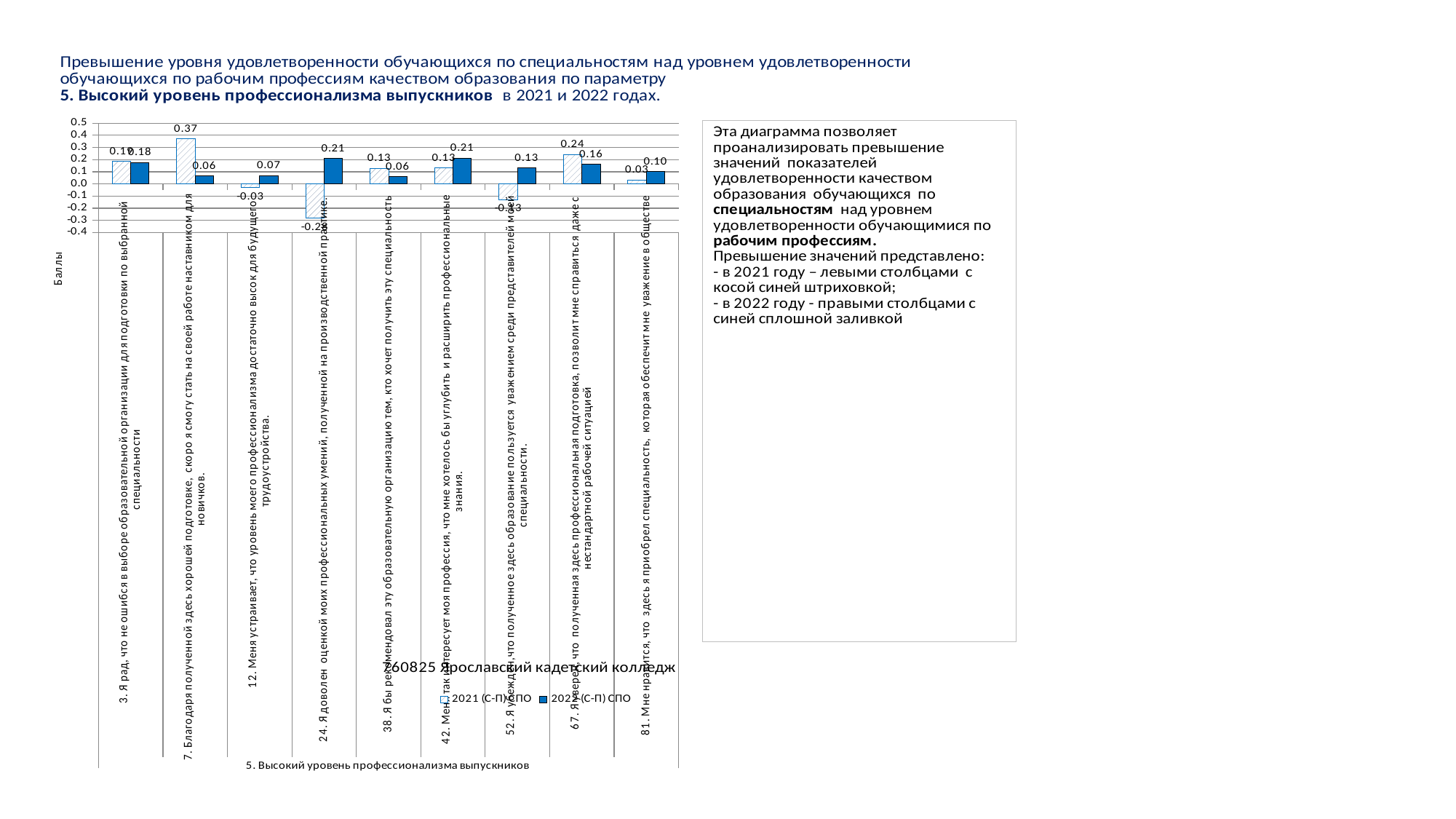
Which statement has the lowest 2021 (С-П) СПО value? 24. Я доволен оценкой моих профессиональных умений, полученной на производственной практике. What is the label of the vertical axis of the chart? Баллы How many series does the chart legend list? 2 Which statement has the lowest 2022 (С-П) СПО value? Statements 7 and 38 are tied at 0.06 (7. Благодаря полученной здесь хорошей подготовке... and 38. Я бы рекомендовал эту образовательную организацию...) How many statement categories are plotted along the x axis of the chart? 9 For statement 67 (Я уверен, что полученная здесь профессиональная подготовка...), which is larger: the 2021 or the 2022 (С-П) СПО value? 2021 (С-П) СПО What is the 2022 (С-П) СПО value for statement 24 (Я доволен оценкой моих профессиональных умений...)? 0.21 Which statement has the highest 2021 (С-П) СПО value? 7. Благодаря полученной здесь хорошей подготовке, скоро я смогу стать на своей работе наставником для новичков. What is the difference between the 2021 and 2022 (С-П) СПО values for statement 7? 0.31 What is the 2021 (С-П) СПО value for statement 7 (Благодаря полученной здесь хорошей подготовке...)? 0.37 What type of chart is shown on the slide? bar chart What is the 2021 (С-П) СПО value for statement 52 (Я убежден, что полученное здесь образование пользуется уважением...)? -0.13